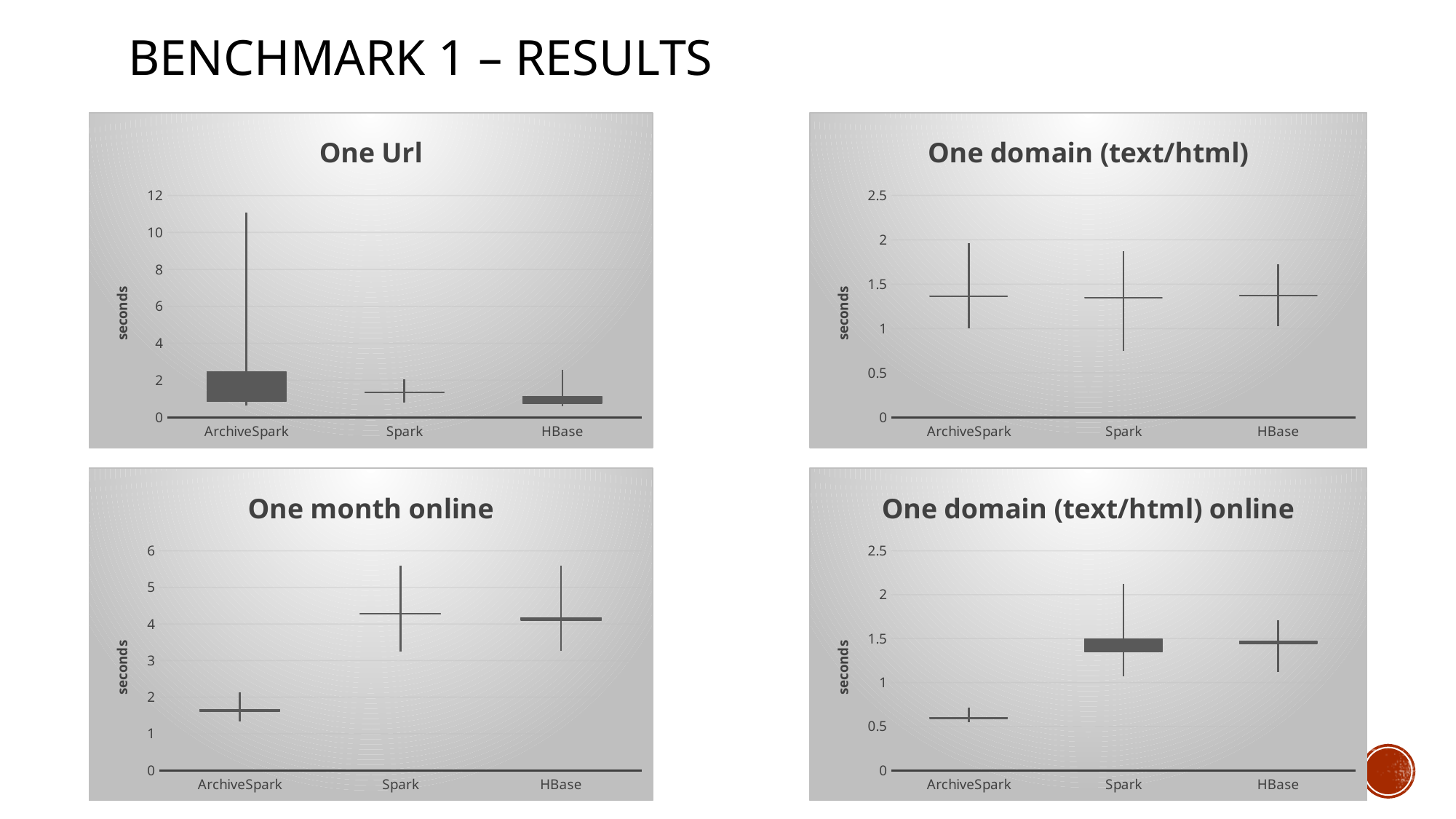
In the 'One domain (text/html) online' chart, is the value for ArchiveSpark greater or less than 1? less In the 'One Url' chart, how many categories are shown on the x axis? 3 In the 'One domain (text/html) online' chart, which category has the lowest values? ArchiveSpark In the 'One Url' chart, is the highest value reached by ArchiveSpark greater or less than 10? greater What is the label on the vertical axis of the 'One month online' chart? seconds How many charts are shown on the slide? 4 What is the title of the chart in the top right of the slide? One domain (text/html) In the 'One domain (text/html) online' chart, is the value for Spark greater or less than 1? greater In the 'One month online' chart, which category has the lowest values? ArchiveSpark In the 'One Url' chart, which category reaches the highest value? ArchiveSpark